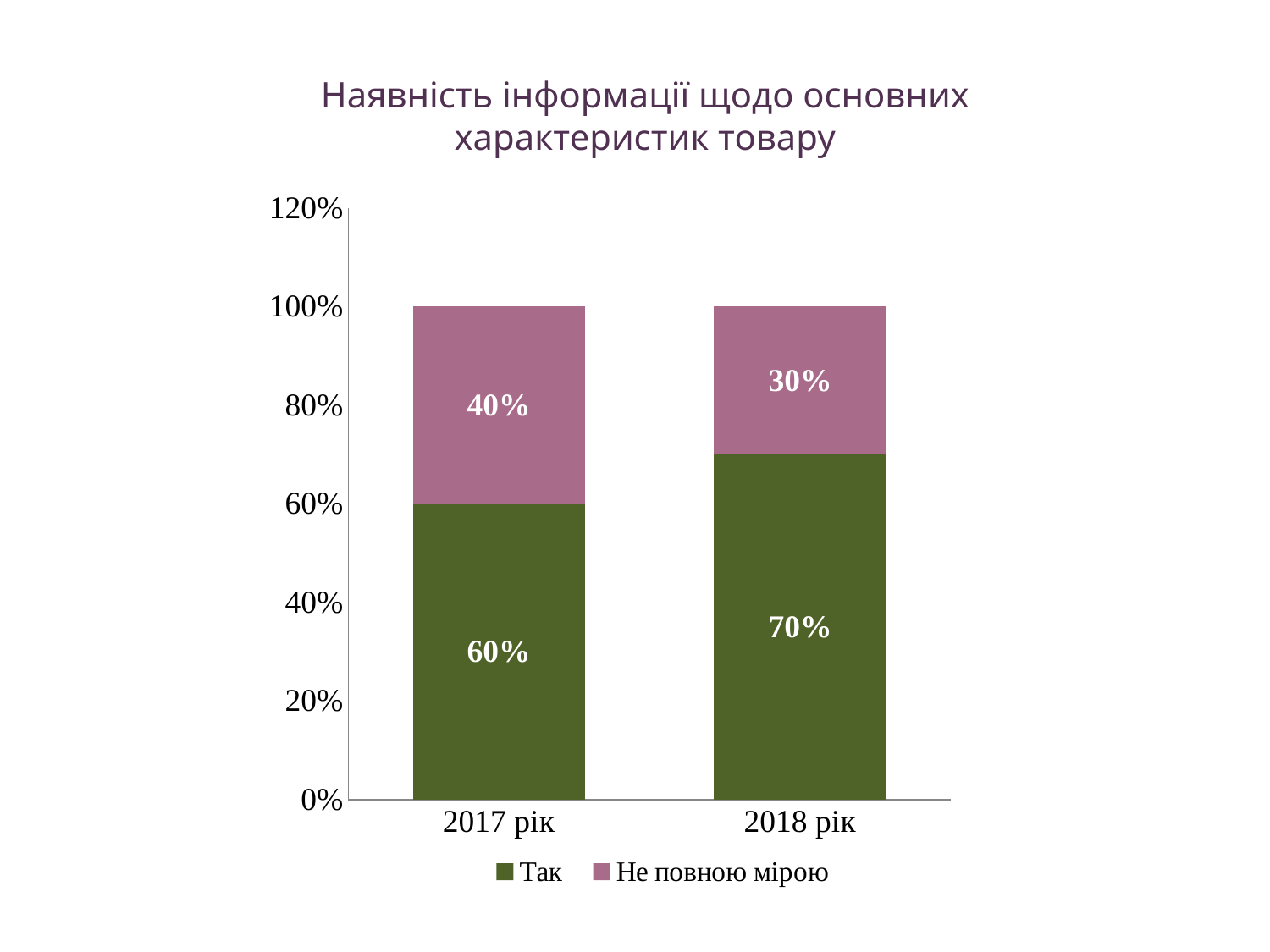
In which year is the "Так" value highest? 2018 рік What is the value for "Не повною мірою" in 2017 рік? 40% What is the value for "Так" in 2018 рік? 70% How many series does the legend list? 2 How many categories are shown on the x axis? 2 What kind of chart is shown on the slide? Stacked bar chart What is the total of the stacked bar for 2017 рік? 100% What is the difference between the "Так" values for 2018 рік and 2017 рік? 10% What is the value for "Не повною мірою" in 2018 рік? 30% In which year is the "Не повною мірою" value lowest? 2018 рік What is the value for "Так" in 2017 рік? 60% Which is larger in 2017 рік: "Так" or "Не повною мірою"? Так